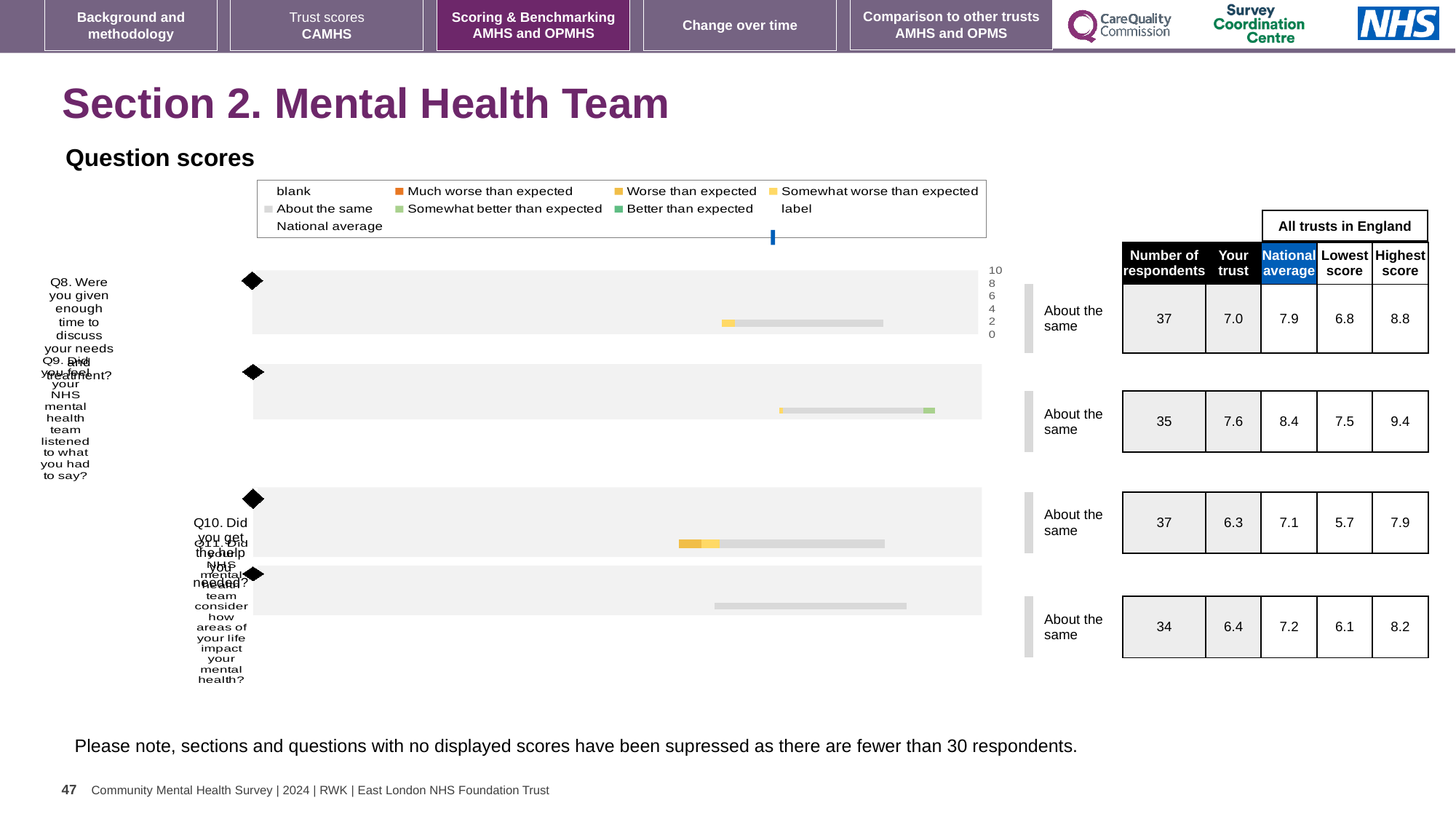
What benchmark category is shown next to each of the four questions in the chart? About the same Which question has the highest 'Your trust' score? Q9 How many questions (Q8 to Q11) are plotted in the question scores chart? 4 How many respondents answered Q11 (Did the NHS mental health team consider how areas of your life impact your mental health?)? 34 Which is larger: the 'Your trust' score for Q9 or for Q11? Q9 What is the highest score among all trusts in England for Q10 (Did you get the help you needed?)? 7.9 What kind of chart is used to show the question scores on this slide? bar chart What is the national average score for Q9 (Did you feel your NHS mental health team listened to what you had to say?)? 8.4 Which question has the lowest 'Your trust' score? Q10 What is the difference between the national average and the 'Your trust' score for Q8? 0.9 What is the lowest score among all trusts in England for Q8? 6.8 What is the 'Your trust' score for Q8 (Were you given enough time to discuss your needs and treatment?)? 7.0